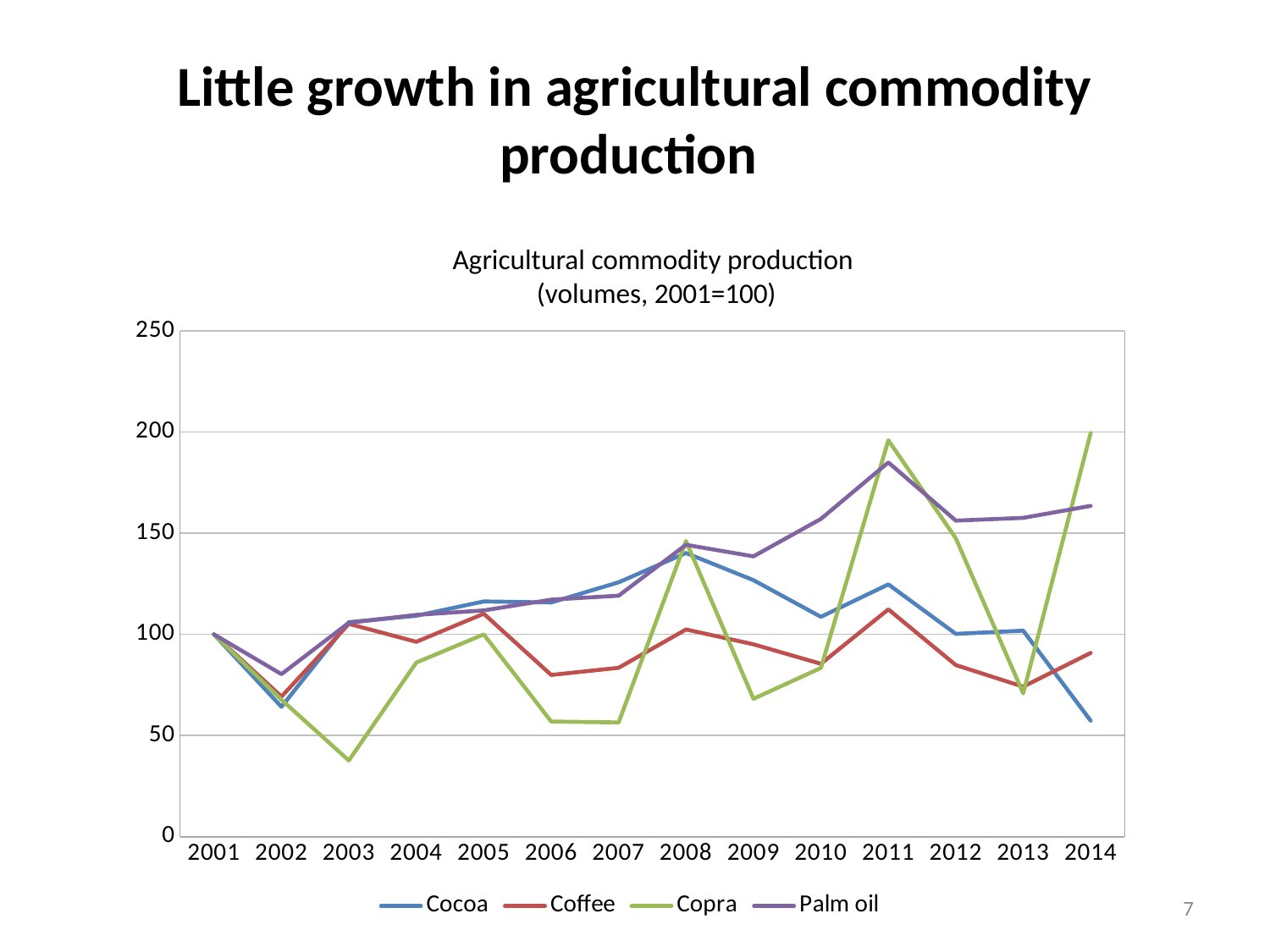
Which series has the highest value in 2011? Copra How many series does the legend list? 4 Which series has the lowest value in 2014? Cocoa What is the value for Cocoa in 2001? 100 How many years are plotted along the x axis? 14 In 2010, which is larger: the value for Palm oil or the value for Coffee? Palm oil What is the title of the chart? Agricultural commodity production (volumes, 2001=100) Is the value for Coffee in 2006 greater or less than 100? less Which series has the lowest value in 2003? Copra Is the value for Palm oil in 2011 greater or less than 150? greater Is the value for Copra in 2003 greater or less than 50? less What kind of chart is shown on the slide? line chart